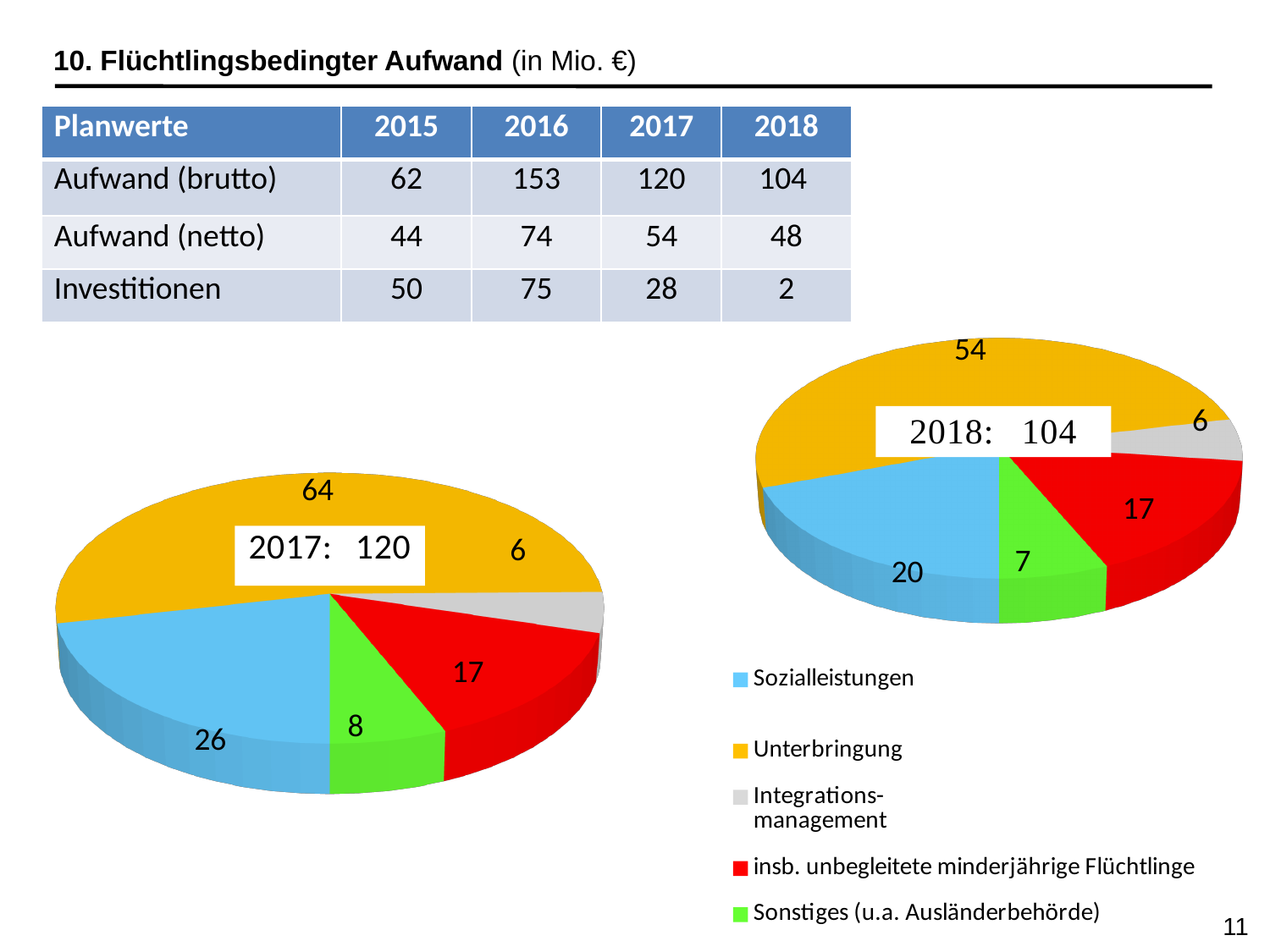
What kind of chart is used to show the 2017 and 2018 breakdowns? Pie chart In the 2018 pie chart, which category has the largest slice? Unterbringung How many entries does the legend list? 5 In the 2017 pie chart, which category has the smallest slice? Integrationsmanagement In the 2017 pie chart, which is larger: Sozialleistungen or insb. unbegleitete minderjährige Flüchtlinge? Sozialleistungen In the 2017 pie chart, what is the value for Sonstiges (u.a. Ausländerbehörde)? 8 In the 2017 pie chart, what is the value for Unterbringung? 64 What total is shown in the centre label of the 2018 pie chart? 104 What is the difference between the Unterbringung value in the 2017 pie chart and the Unterbringung value in the 2018 pie chart? 10 In the 2018 pie chart, what is the value for insb. unbegleitete minderjährige Flüchtlinge? 17 How many slices does the 2018 pie chart have? 5 In the 2018 pie chart, what is the value for Sozialleistungen? 20